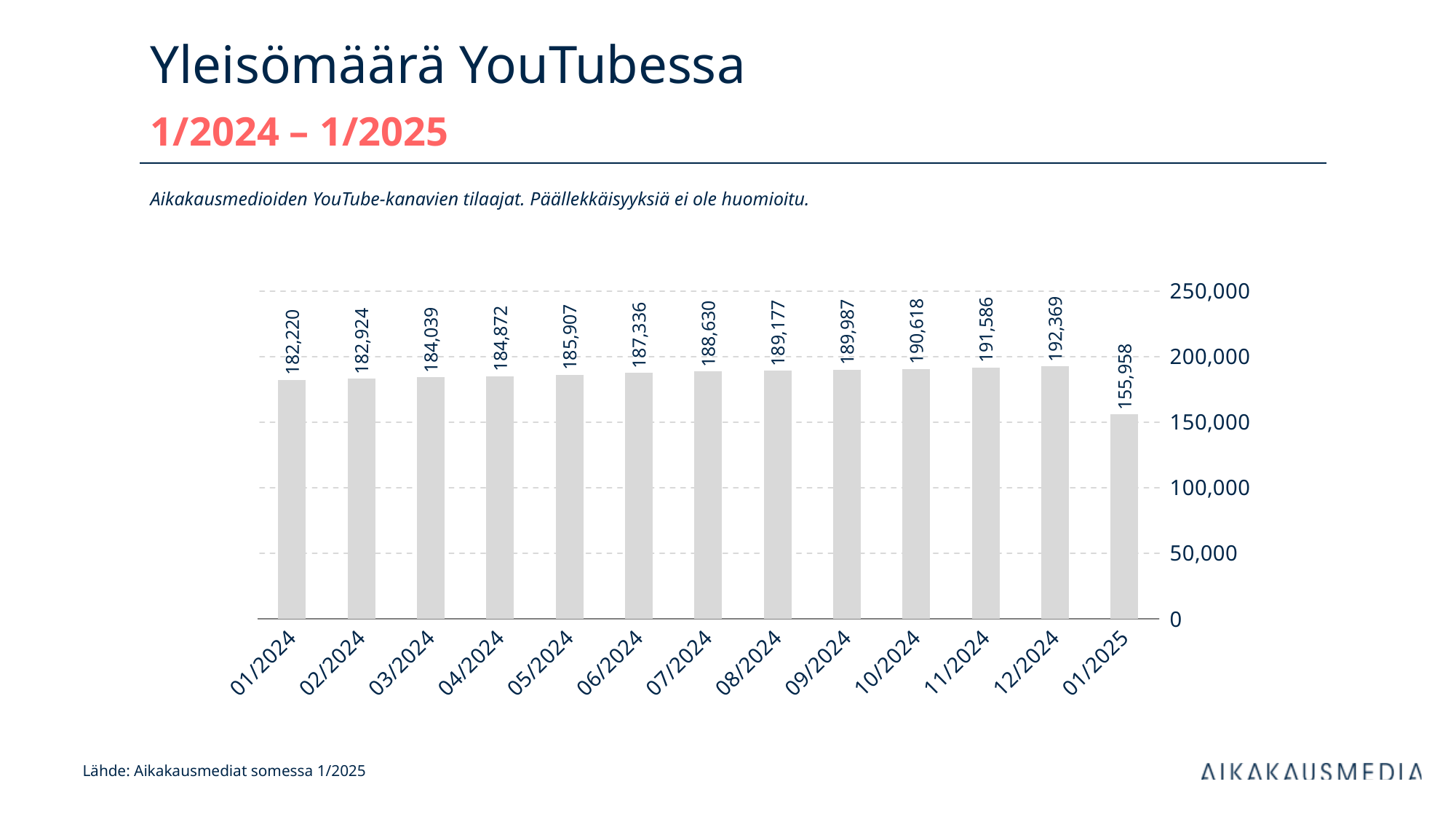
What is the value for 12/2024? 192,369 How many months are shown on the x axis? 13 Which month has the highest value? 12/2024 What is the difference between the values for 12/2024 and 01/2025? 36,411 What is the difference between the values for 12/2024 and 01/2024? 10,149 What is the value for 01/2024? 182,220 Is the value for 01/2025 greater or less than 200,000? less What is the value for 06/2024? 187,336 Which is larger, the value for 09/2024 or the value for 01/2025? 09/2024 Which month has the lowest value? 01/2025 What is the value for 01/2025? 155,958 What kind of chart is shown on the slide? bar chart